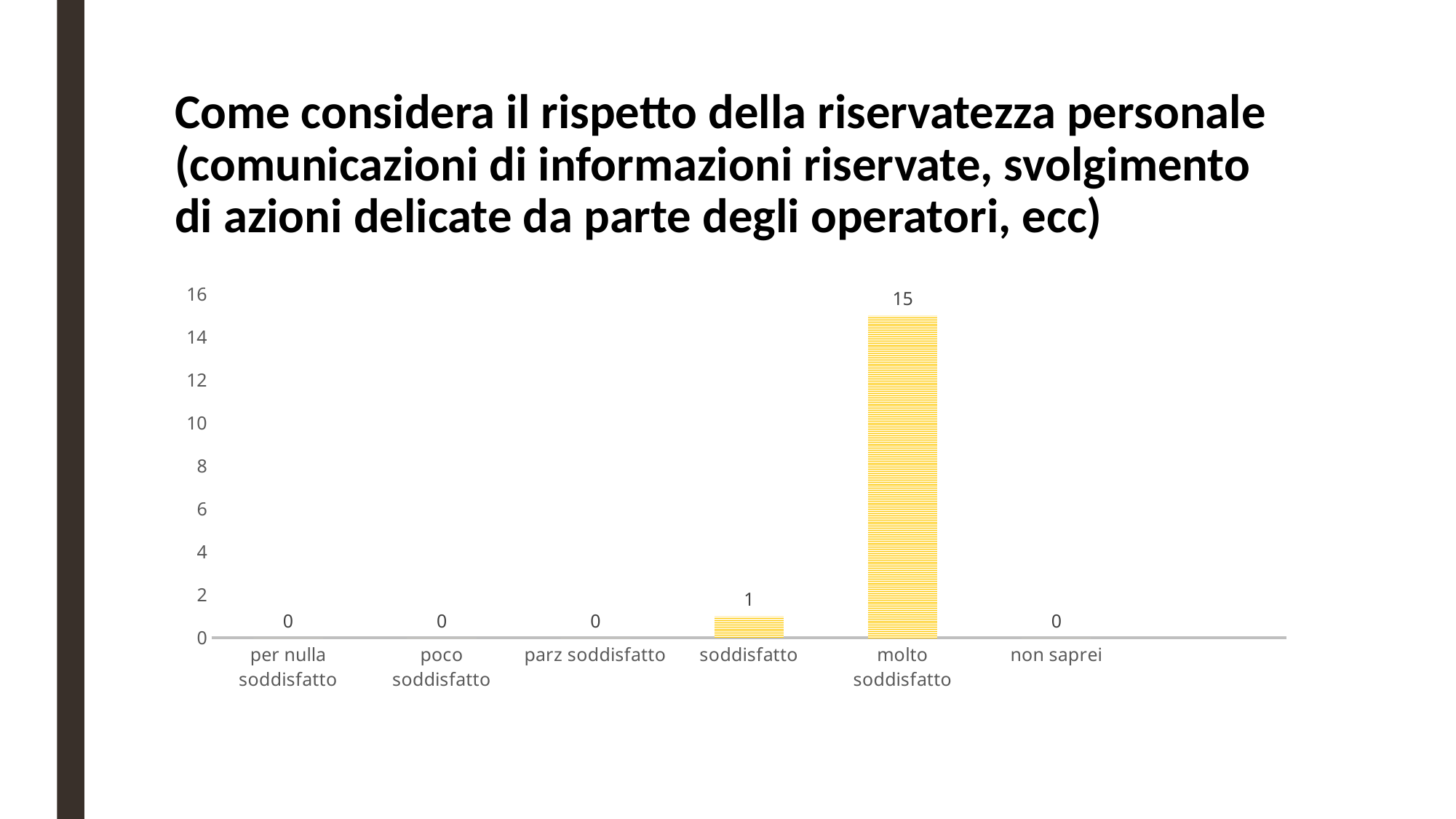
What is the difference between the values for "molto soddisfatto" and "soddisfatto"? 14 What is the value for "parz soddisfatto"? 0 What is the total of all the values shown in the chart? 16 How many categories have a value of 0? 4 Is the value for "molto soddisfatto" greater or less than 10? greater What is the value for "molto soddisfatto"? 15 What is the value for "non saprei"? 0 Which is larger, the value for "soddisfatto" or the value for "poco soddisfatto"? soddisfatto Which category has the highest value? molto soddisfatto What is the value for "soddisfatto"? 1 How many categories are shown on the x axis? 6 What kind of chart is shown on the slide? bar chart